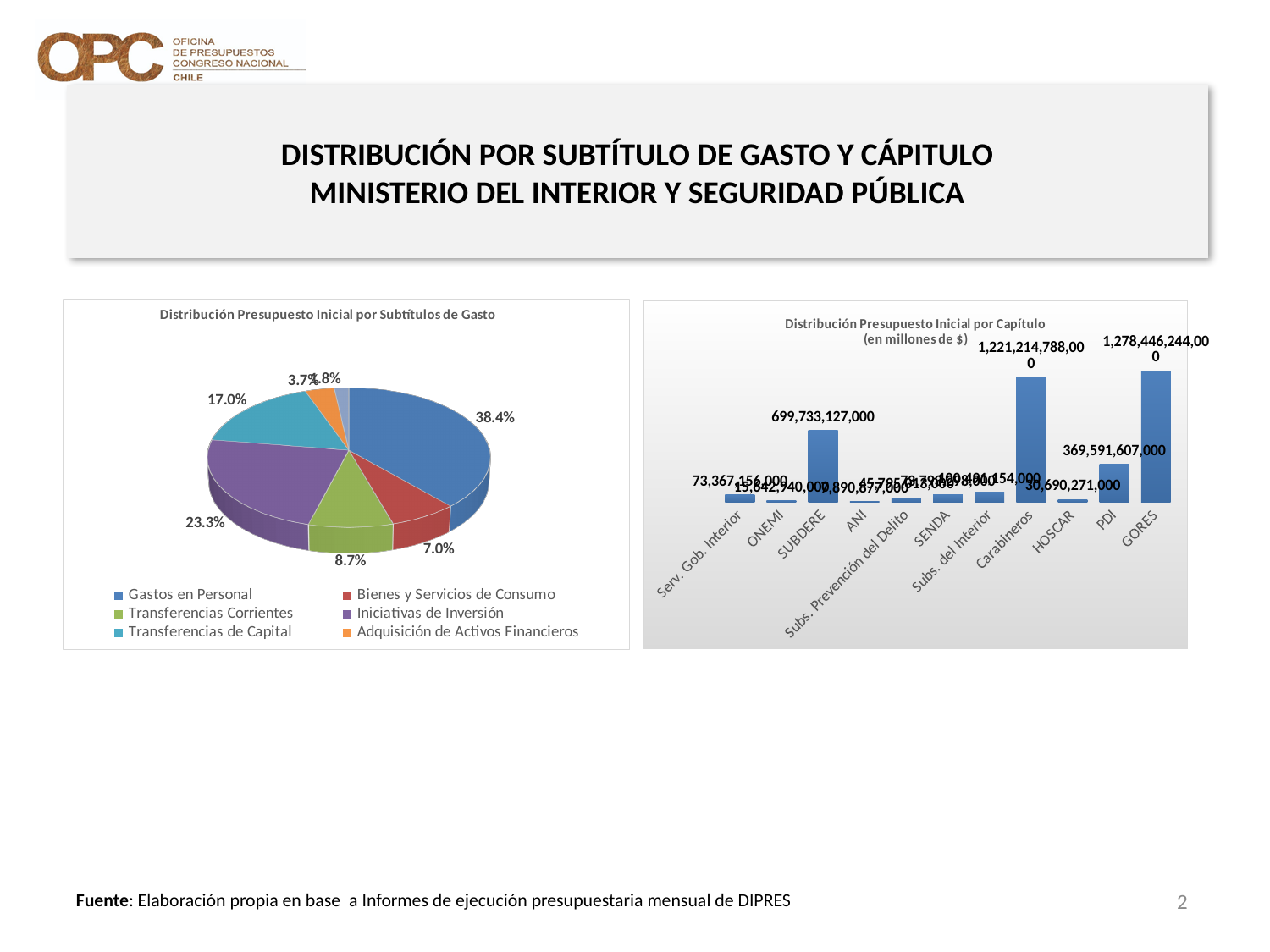
In the right bar chart, what is the value for Carabineros? 1,221,214,788,000 In the left pie chart, which category has the largest slice? Gastos en Personal In the left pie chart, what share does Iniciativas de Inversión have? 23.3% How many capítulos are shown on the x axis of the right bar chart? 11 In the right bar chart, what is the difference between the values for GORES and Carabineros? 57,231,456,000 What kind of chart is the right chart, 'Distribución Presupuesto Inicial por Capítulo'? Bar chart In the left pie chart, what share does Transferencias de Capital have? 17.0% How many entries does the legend of the left pie chart list? 6 In the right bar chart, which capítulo has the highest value? GORES In the left pie chart, which is larger: Transferencias Corrientes or Bienes y Servicios de Consumo? Transferencias Corrientes In the left pie chart, what share does Gastos en Personal have? 38.4% What kind of chart is the left chart, 'Distribución Presupuesto Inicial por Subtítulos de Gasto'? Pie chart